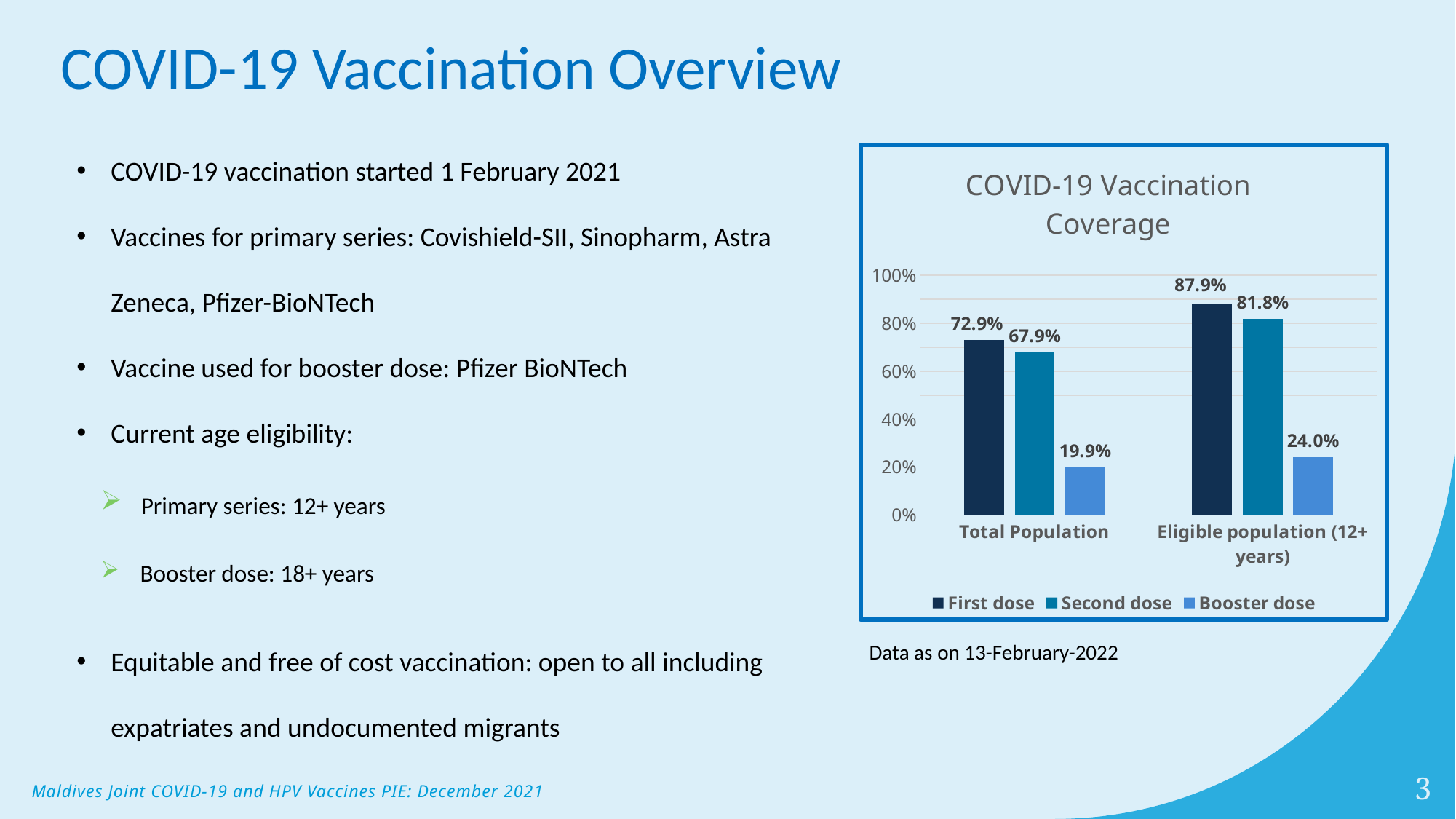
What is the second dose coverage for the Eligible population (12+ years)? 81.8% What is the first dose coverage for the Total Population? 72.9% What is the difference between booster dose coverage for the Eligible population (12+ years) and the Total Population? 4.1% Which series has the lowest value for the Total Population? Booster dose What is the booster dose coverage for the Eligible population (12+ years)? 24.0% How many series does the legend list? 3 What kind of chart is shown on the slide? Bar chart What is the difference between first dose and second dose coverage for the Total Population? 5.0% How many categories are shown on the x axis? 2 What is the booster dose coverage for the Total Population? 19.9% Which is larger: second dose coverage for the Total Population or second dose coverage for the Eligible population (12+ years)? Eligible population (12+ years) Which series has the highest value for the Eligible population (12+ years)? First dose